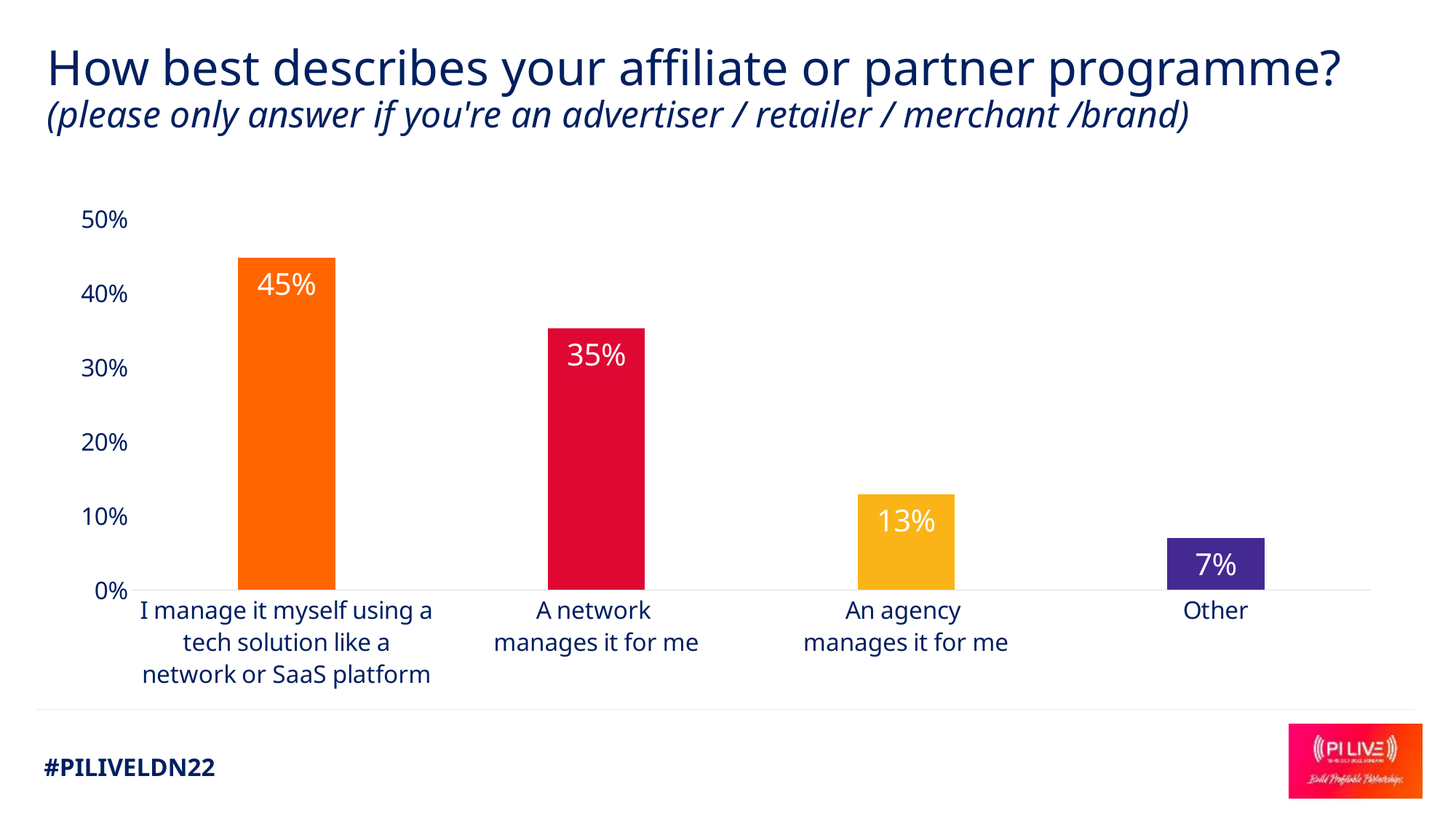
Do the values rise or fall from left to right across the categories? Fall Which category has the highest percentage? I manage it myself using a tech solution like a network or SaaS platform What is the difference in percentage points between 'An agency manages it for me' and 'Other'? 6 percentage points How many categories are shown in the chart? 4 What is the difference in percentage points between 'I manage it myself using a tech solution like a network or SaaS platform' and 'A network manages it for me'? 10 percentage points Which category has the lowest percentage? Other What kind of chart is shown on the slide? Bar chart Which is larger: the value for 'A network manages it for me' or the value for 'An agency manages it for me'? A network manages it for me What percentage of respondents said a network manages their programme for them? 35% What percentage of respondents said an agency manages their programme for them? 13% What percentage of respondents chose 'Other'? 7% What percentage of respondents said they manage their programme themselves using a tech solution like a network or SaaS platform? 45%